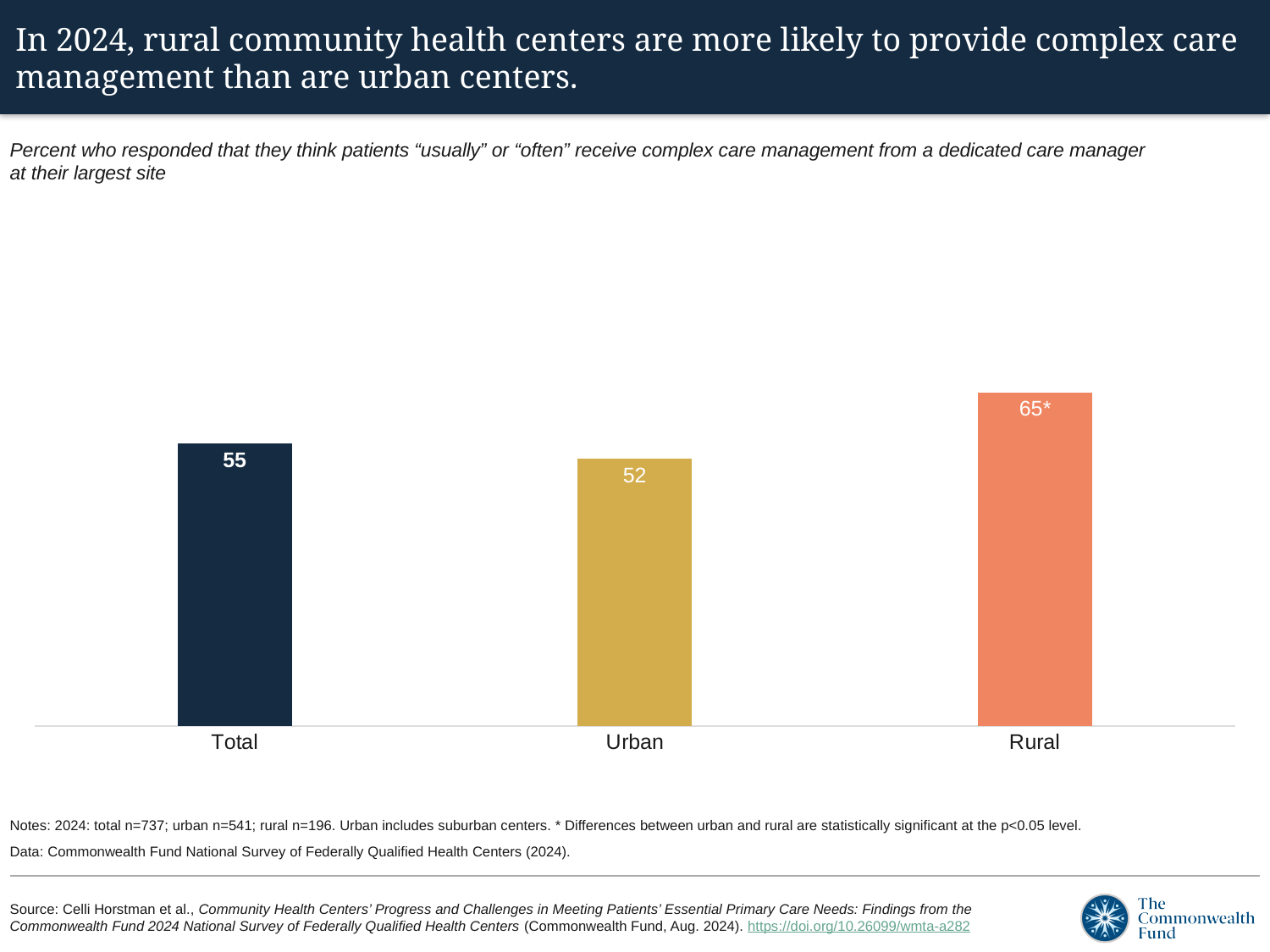
What is the difference between the Total and Urban values? 3 Which category has the lowest value? Urban What colour is the Urban bar? Yellow What is the value for Total? 55 What is the value for Rural? 65* How many categories are shown in the chart? 3 Which category's bar is marked with an asterisk? Rural What kind of chart is shown on the slide? Bar chart Which category has the highest value? Rural Which is larger, the value for Urban or the value for Rural? Rural What is the value for Urban? 52 What is the difference between the Rural and Urban values? 13